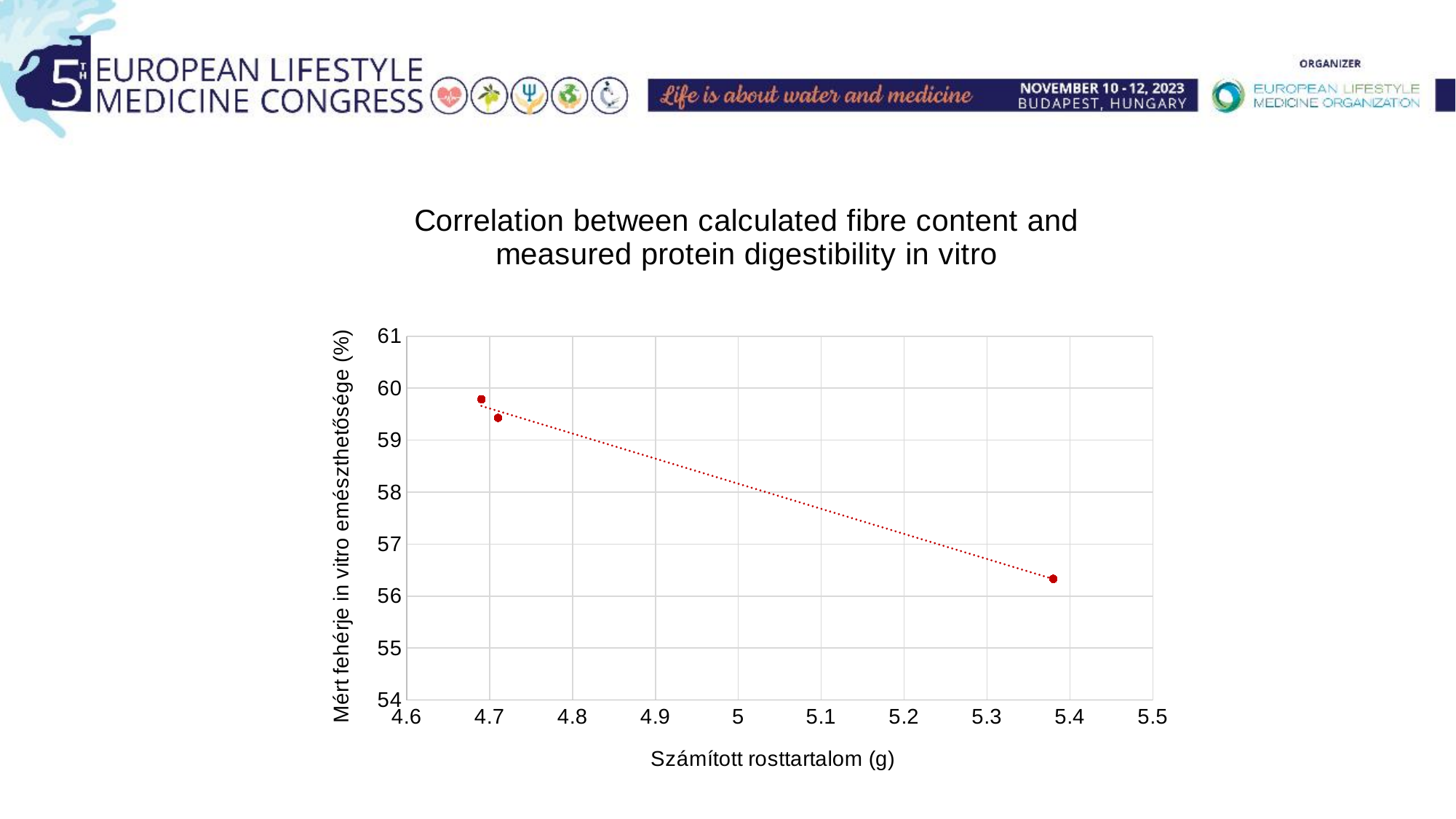
What kind of chart is shown on the slide? scatter chart Is the digestibility value for the point at about 5.4 g fibre greater or less than 56? greater Do the plotted values rise or fall as the calculated fibre content increases along the x axis? fall What is the title of the chart? Correlation between calculated fibre content and measured protein digestibility in vitro Is the digestibility value for the highest point near 4.7 g fibre greater or less than 59? greater What is the label of the x axis? Számított rosttartalom (g) Which plotted point has the lowest measured protein digestibility: the one near 4.7 g fibre or the one near 5.4 g fibre? the one near 5.4 g fibre Is the digestibility value for the point near 5.4 g fibre larger or smaller than the values for the points near 4.7 g fibre? smaller Is the digestibility value for the point at about 5.4 g fibre greater or less than 57? less How many data points are plotted on the chart? 3